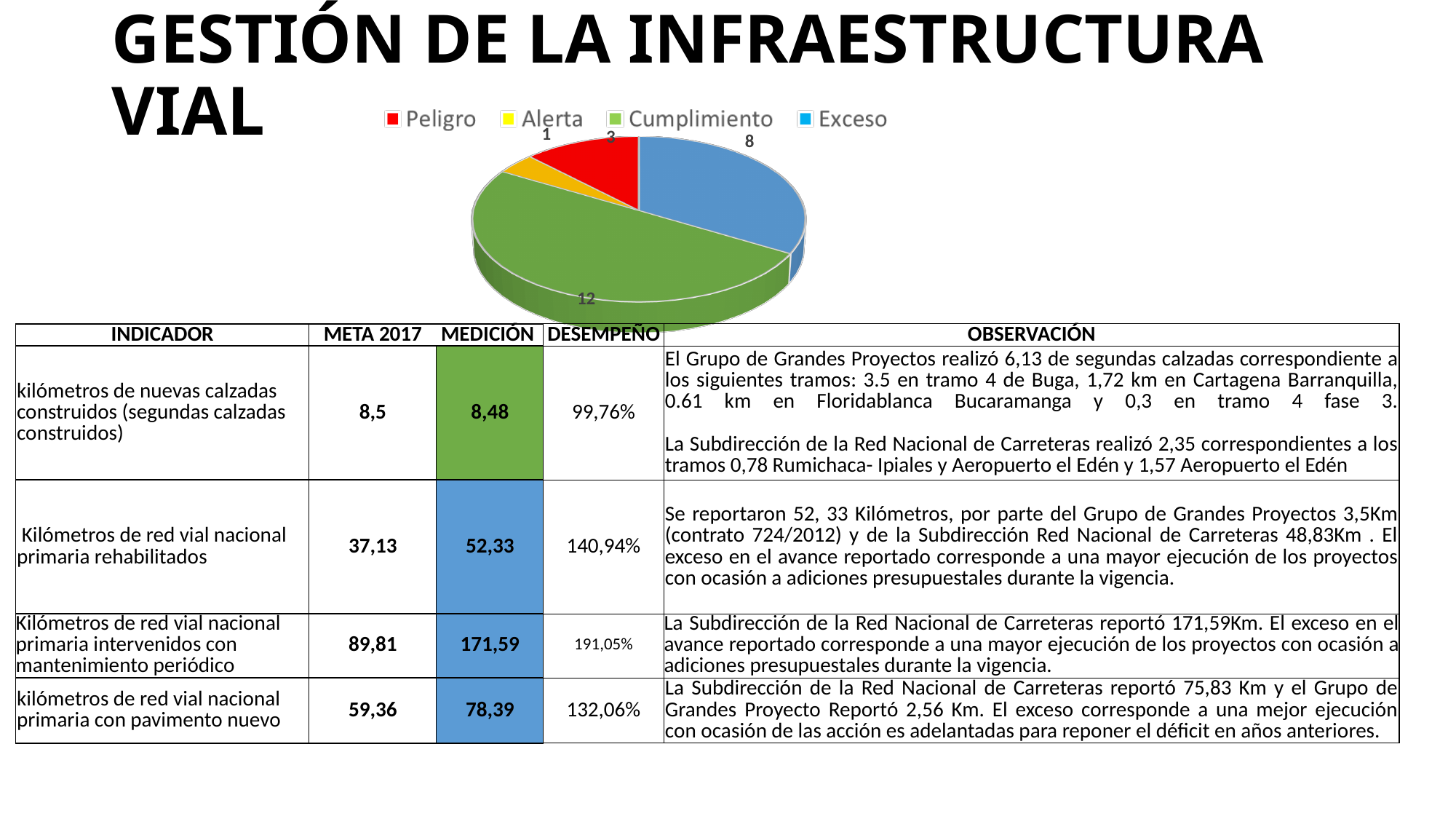
Which category has the smallest slice in the pie chart? Alerta What is the difference between the Cumplimiento and Exceso values in the pie chart? 4 What is the value of the Exceso slice in the pie chart? 8 Which is larger in the pie chart, Peligro or Exceso? Exceso Which category has the largest slice in the pie chart? Cumplimiento What is the value of the Peligro slice in the pie chart? 3 How many entries does the legend of the pie chart list? 4 What is the value of the Cumplimiento slice in the pie chart? 12 What colour is the Peligro slice in the pie chart? Red What share of the pie chart does the Cumplimiento slice represent? 50% What is the value of the Alerta slice in the pie chart? 1 What kind of chart is shown on the slide? Pie chart